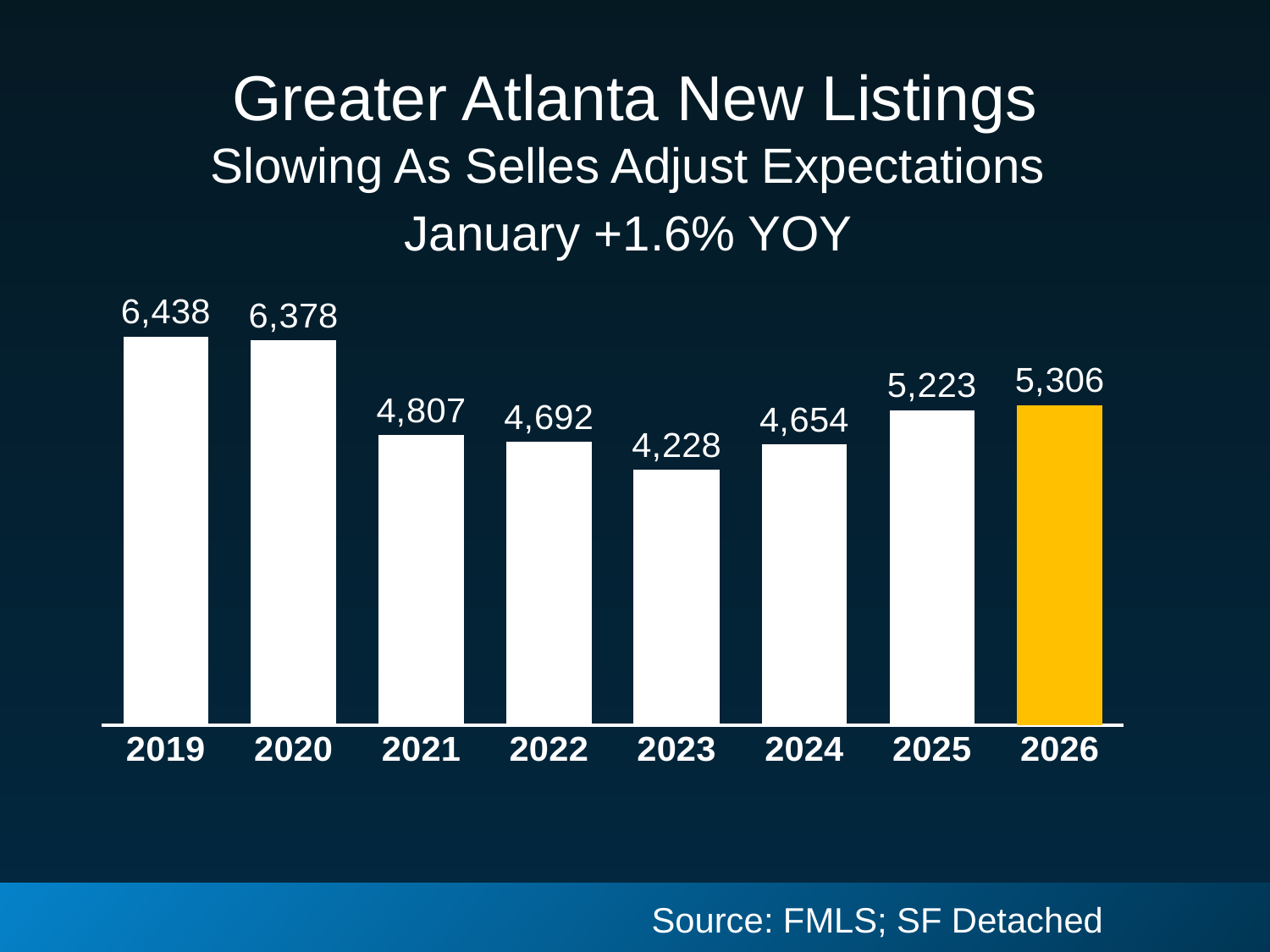
What is the value for 2026? 5,306 What is the difference between the values for 2026 and 2025? 83 What kind of chart is this? bar chart How many years are shown on the chart? 8 What is the value for 2023? 4,228 What is the value for 2019? 6,438 Which is larger, the value for 2021 or the value for 2024? 2021 What is the difference between the values for 2019 and 2023? 2,210 Which bar is coloured differently from the others? 2026 Which year has the lowest value? 2023 Do the values rise or fall from 2023 to 2026? rise Which year has the highest value? 2019